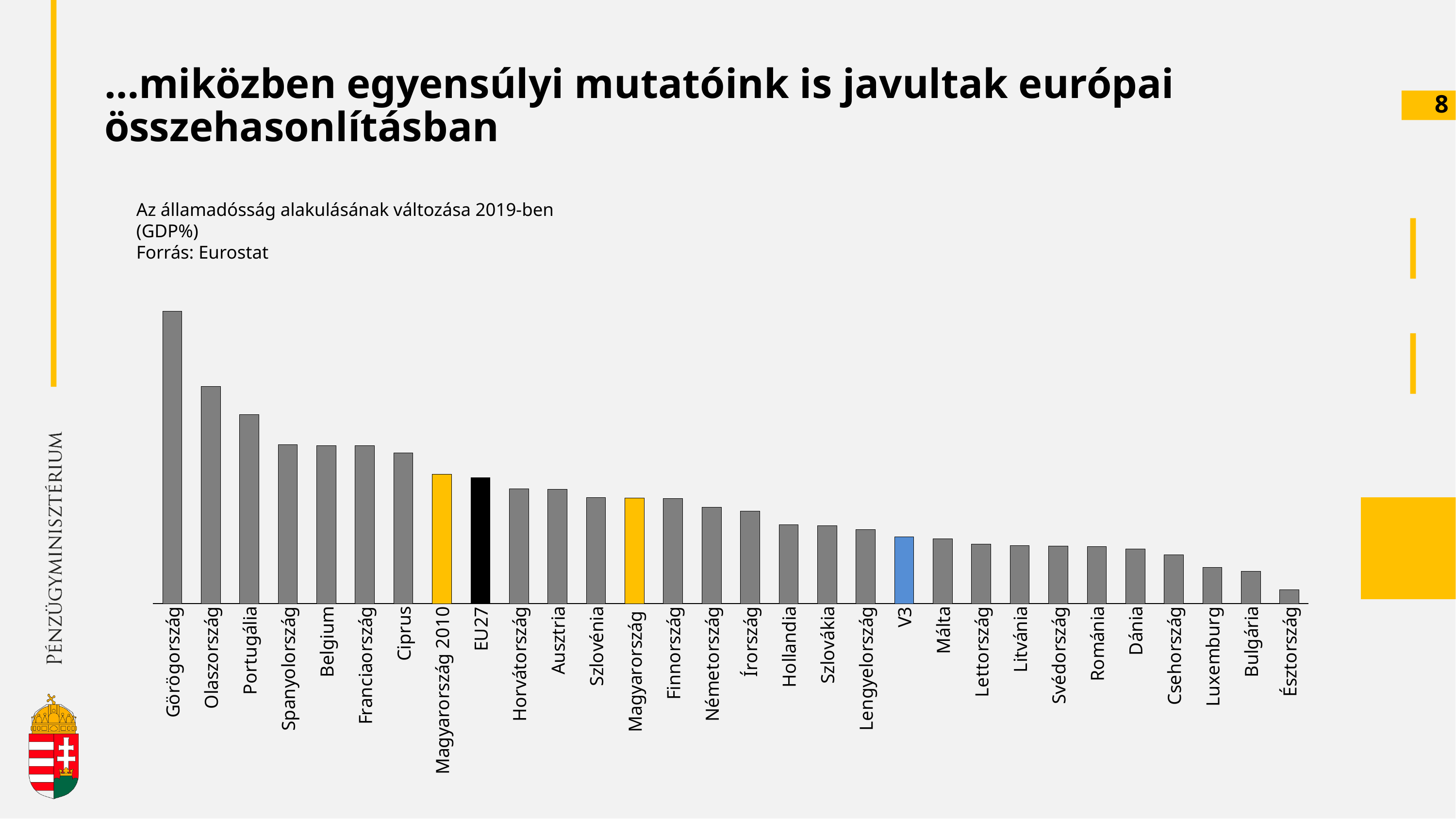
Which category has the highest bar in the chart? Görögország How many bars (categories) are plotted in the chart? 30 What kind of chart is shown on the slide? Bar chart Which bar is taller: Bulgária or Luxemburg? Luxemburg Do the bar values rise or fall moving from left to right along the x axis? Fall Which bar is taller: Görögország or Olaszország? Görögország What colour is the bar for EU27? Black Which bar is taller: Magyarország 2010 or Magyarország? Magyarország 2010 What is the source of the data cited on the slide? Eurostat Which category has the lowest bar in the chart? Észtország